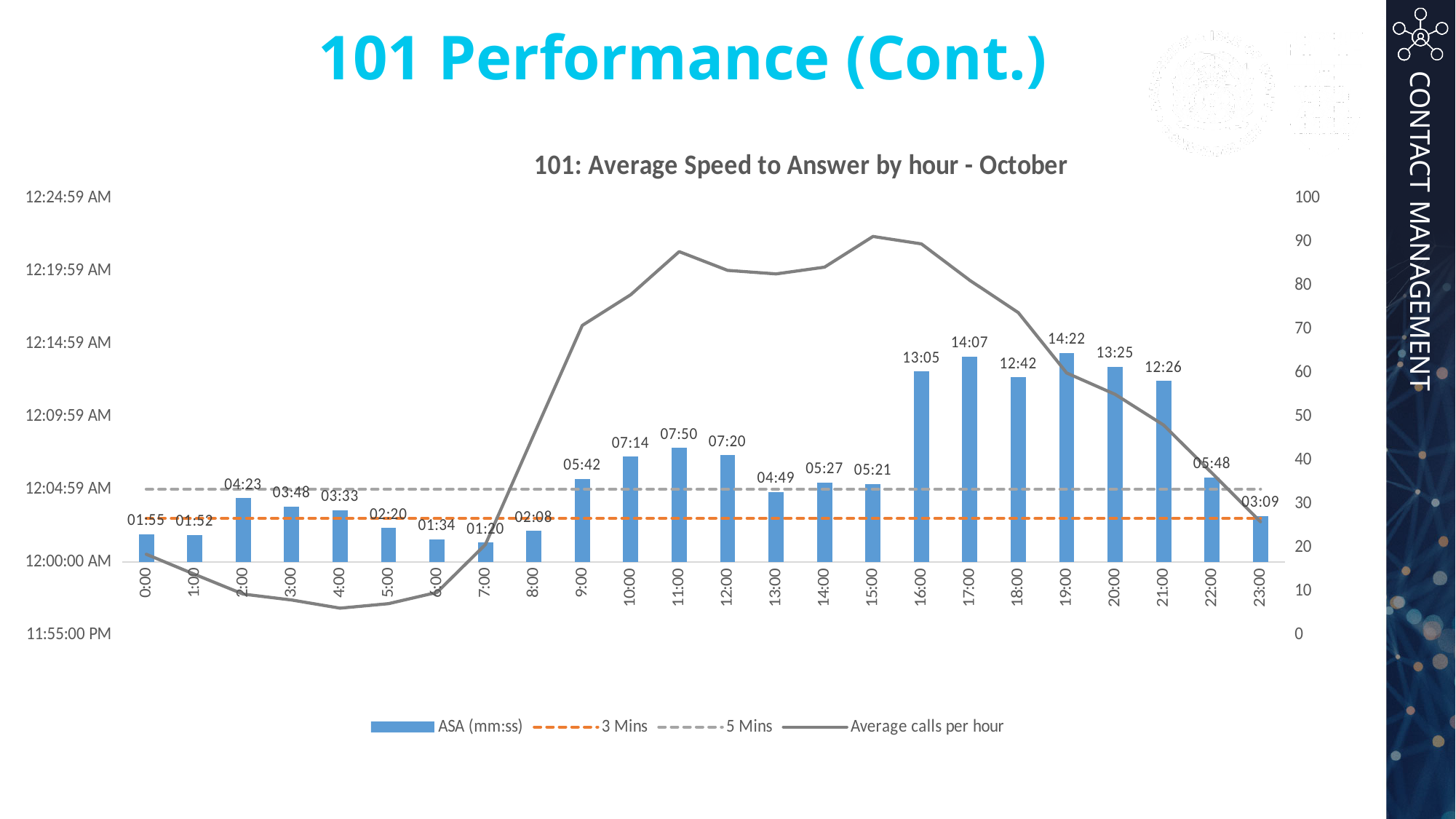
Do the ASA values rise or fall from 19:00 to 23:00? fall How many hourly categories are shown on the x axis? 24 What is the ASA value for 11:00? 07:50 Which hour has the highest ASA? 19:00 What is the ASA value for 23:00? 03:09 What is the difference between the ASA at 11:00 and the ASA at 10:00? 00:36 How many series does the legend list? 4 Is the average calls per hour value at 15:00 greater or less than 80? greater Which hour has the lowest ASA? 7:00 Which has the larger ASA, 16:00 or 20:00? 20:00 Is the average calls per hour value at 4:00 greater or less than 10? less What is the ASA value for 17:00? 14:07